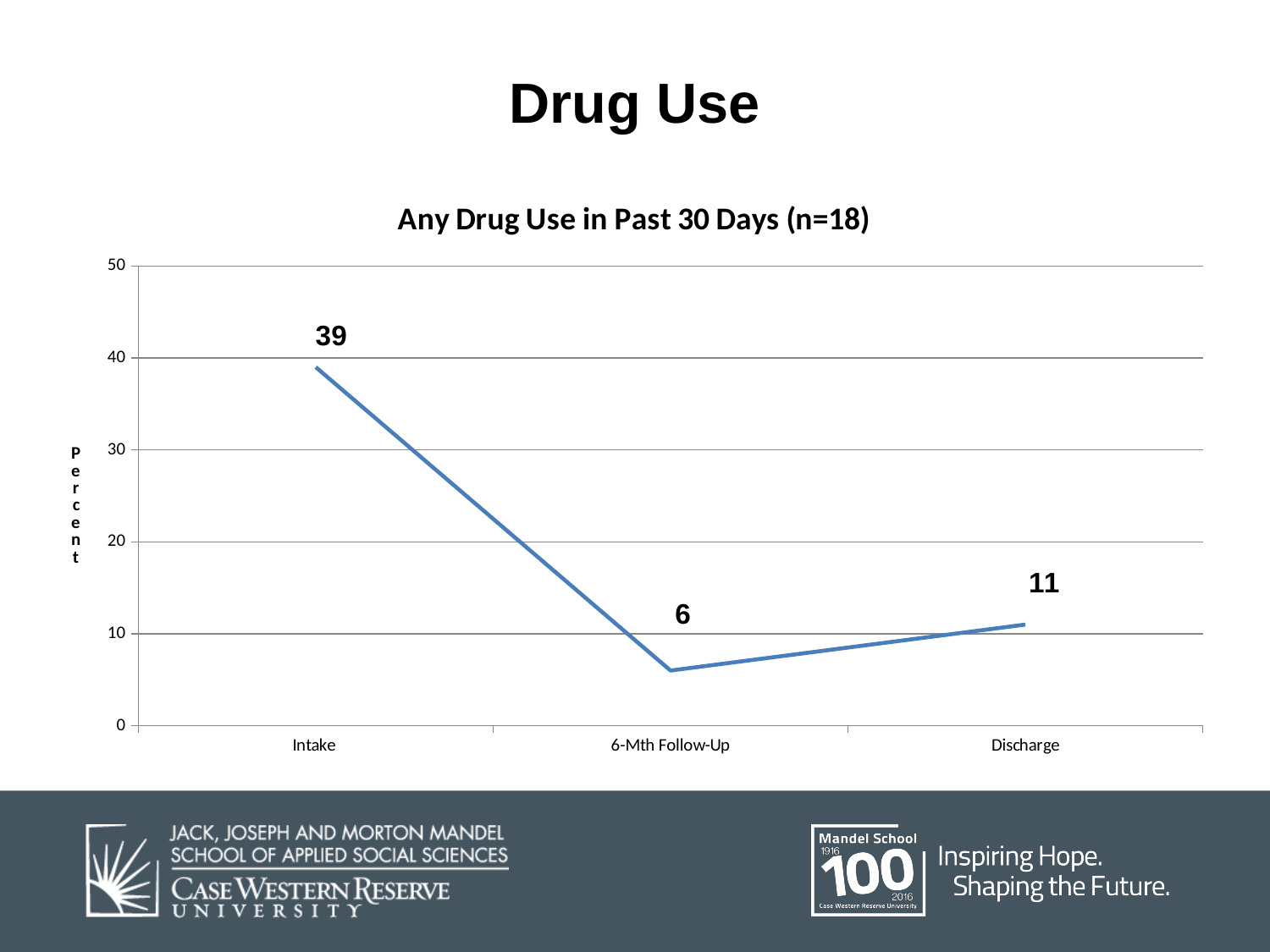
Which time point has the lowest value? 6-Mth Follow-Up What kind of chart is shown on the slide? line chart What is the value at Discharge? 11 Which time point has the highest value? Intake How many time points are plotted on the chart? 3 What is the value at 6-Mth Follow-Up? 6 What is the difference between the Discharge value and the 6-Mth Follow-Up value? 5 What is the value for Intake? 39 What is the difference between the Intake value and the 6-Mth Follow-Up value? 33 Which is larger, the value at Discharge or the value at 6-Mth Follow-Up? Discharge Is the value for Intake greater or less than 30? greater What is the title of the chart? Any Drug Use in Past 30 Days (n=18)